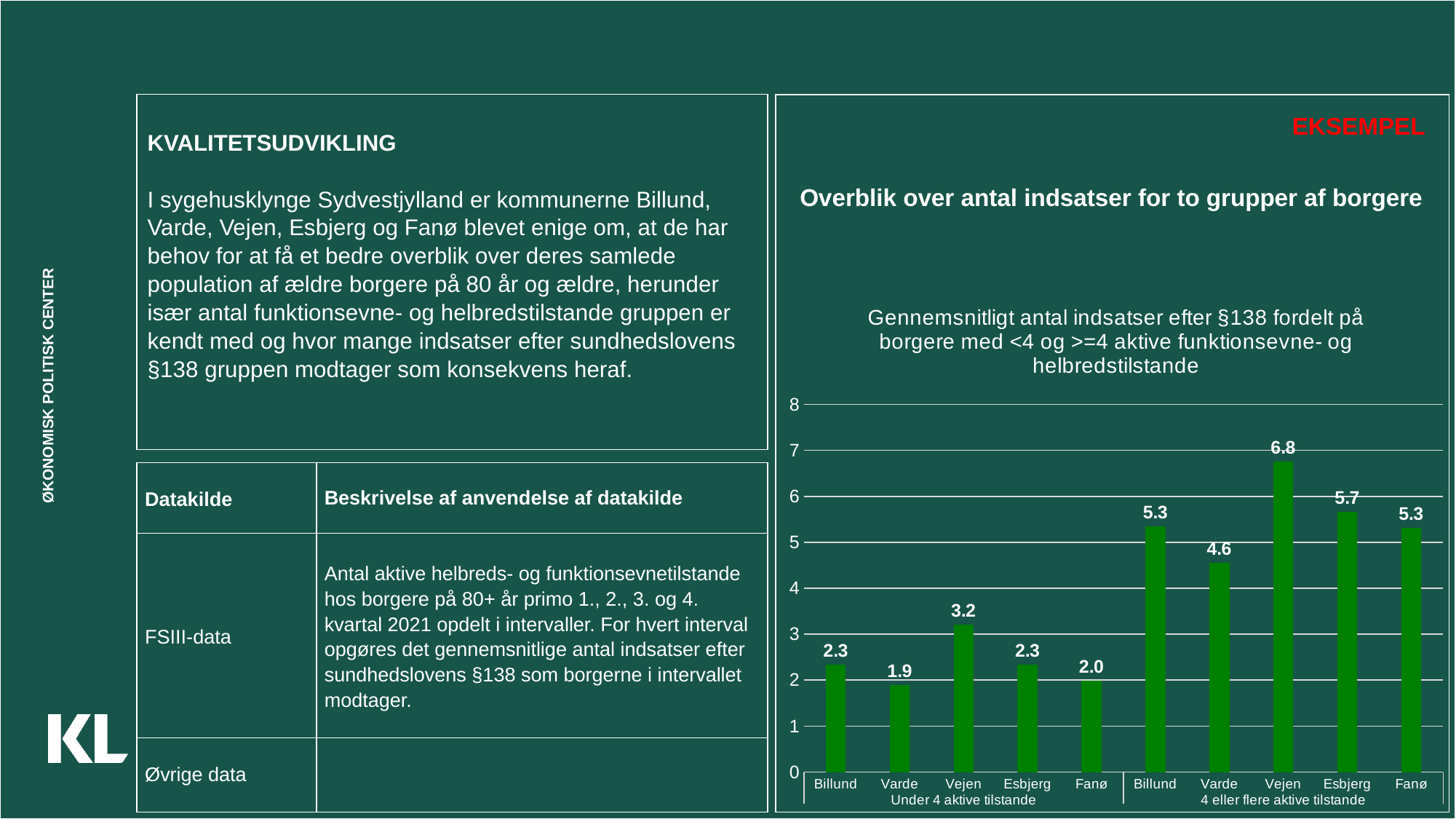
Which is larger: Esbjerg's value in the '4 eller flere aktive tilstande' group or Fanø's value in the same group? Esbjerg What are the two group labels shown below the x-axis of the chart? Under 4 aktive tilstande; 4 eller flere aktive tilstande What is the value for Varde in the '4 eller flere aktive tilstande' group? 4.6 What is the difference between Esbjerg's and Billund's values in the '4 eller flere aktive tilstande' group? 0.4 Which municipality has the lowest value in the 'Under 4 aktive tilstande' group? Varde How many bars are plotted in the chart in total? 10 What is the value for Vejen in the 'Under 4 aktive tilstande' group? 3.2 Which municipality has the highest value in the '4 eller flere aktive tilstande' group? Vejen What is the value for Fanø in the 'Under 4 aktive tilstande' group? 2.0 What is the highest value shown on the y-axis of the chart? 8 What is the difference between Vejen's value in the '4 eller flere aktive tilstande' group and its value in the 'Under 4 aktive tilstande' group? 3.6 What type of chart is shown on the slide? bar chart